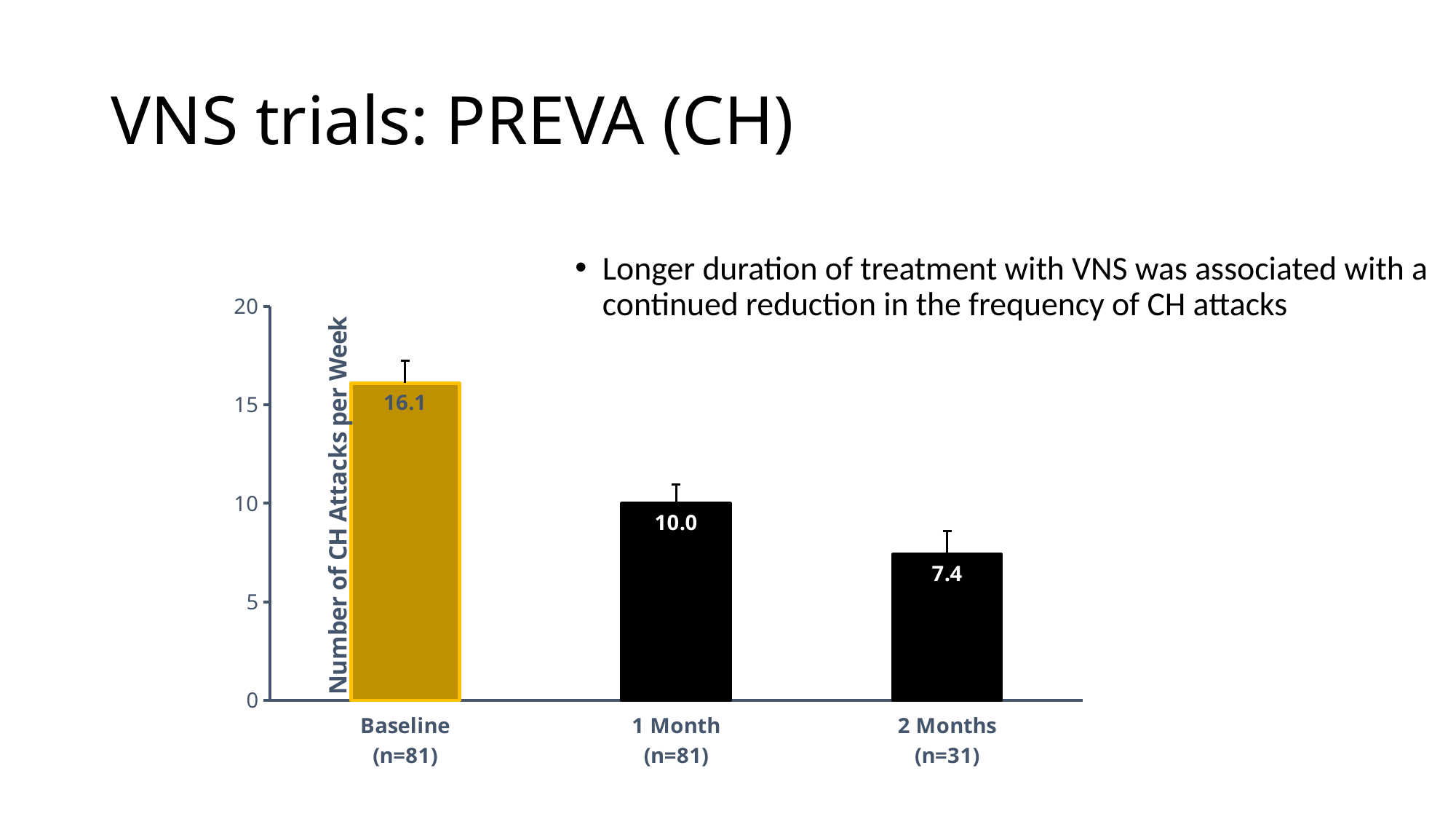
What is the difference in CH attacks per week between Baseline and 1 Month? 6.1 Which time point has the highest number of CH attacks per week? Baseline What is the number of CH attacks per week at 1 Month? 10.0 What is the number of CH attacks per week at Baseline? 16.1 Is the value for Baseline greater or less than 15? greater How many time points are shown on the chart? 3 What is the difference in CH attacks per week between Baseline and 2 Months? 8.7 What is the number of CH attacks per week at 2 Months? 7.4 Which time point has the lowest number of CH attacks per week? 2 Months What kind of chart is shown on the slide? Bar chart Which has more CH attacks per week, 1 Month or 2 Months? 1 Month Do the values rise or fall from Baseline to 2 Months? Fall